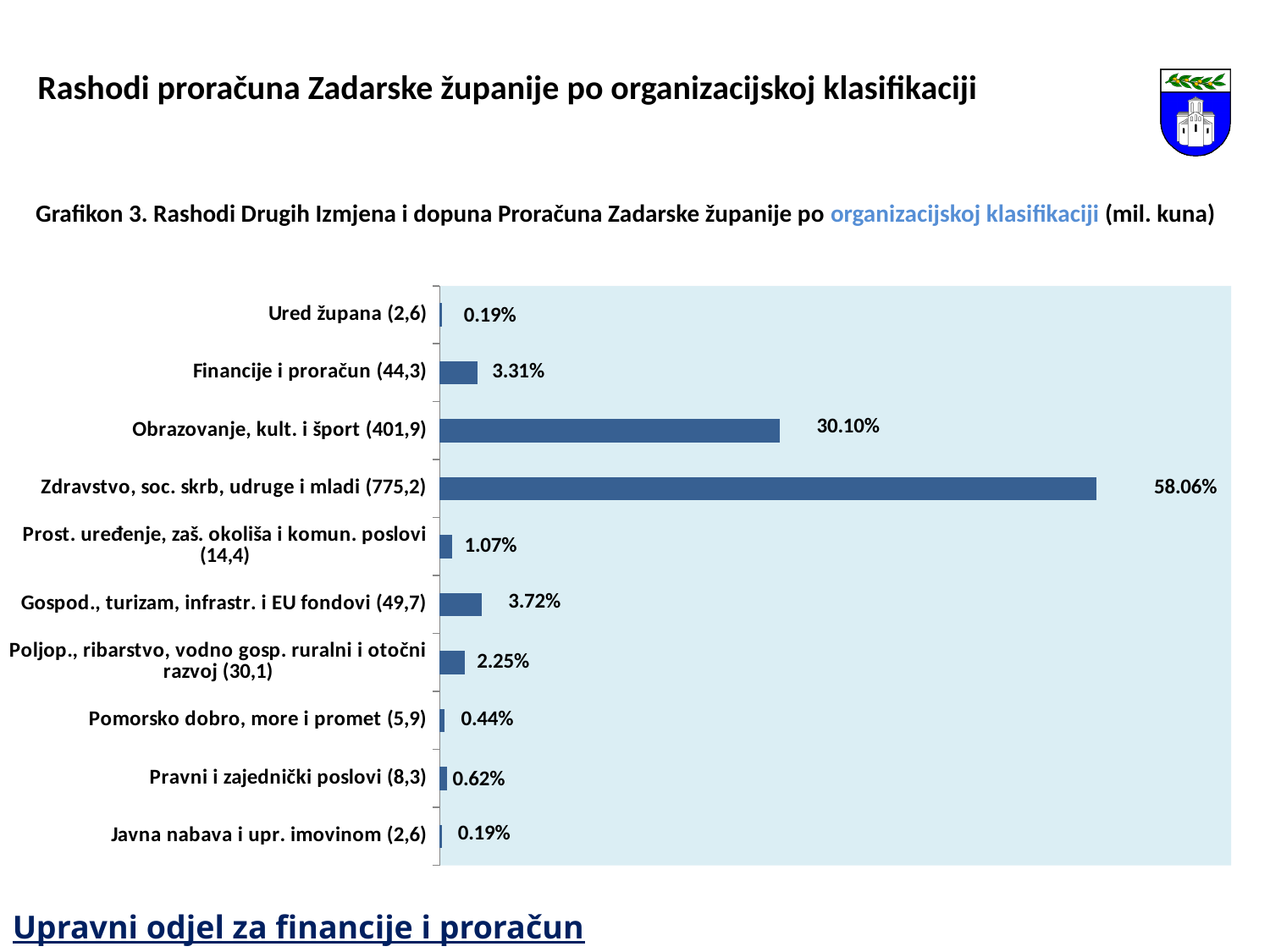
What is the value shown for Pomorsko dobro, more i promet (5,9)? 0.44% How many categories are shown in the chart? 10 Which is larger, the value for Gospod., turizam, infrastr. i EU fondovi (49,7) or the value for Financije i proračun (44,3)? Gospod., turizam, infrastr. i EU fondovi (49,7) What kind of chart is shown on the slide? Bar chart What is the value shown for Gospod., turizam, infrastr. i EU fondovi (49,7)? 3.72% What unit is stated in the chart title for the amounts in parentheses? mil. kuna What is the value shown for Pravni i zajednički poslovi (8,3)? 0.62% What is the value shown for Financije i proračun (44,3)? 3.31% Which category has the highest value? Zdravstvo, soc. skrb, udruge i mladi (775,2) What is the value shown for Obrazovanje, kult. i šport (401,9)? 30.10% What is the difference between the values for Poljop., ribarstvo, vodno gosp. ruralni i otočni razvoj (30,1) and Prost. uređenje, zaš. okoliša i komun. poslovi (14,4)? 1.18% What is the difference between the values for Zdravstvo, soc. skrb, udruge i mladi (775,2) and Obrazovanje, kult. i šport (401,9)? 27.96%